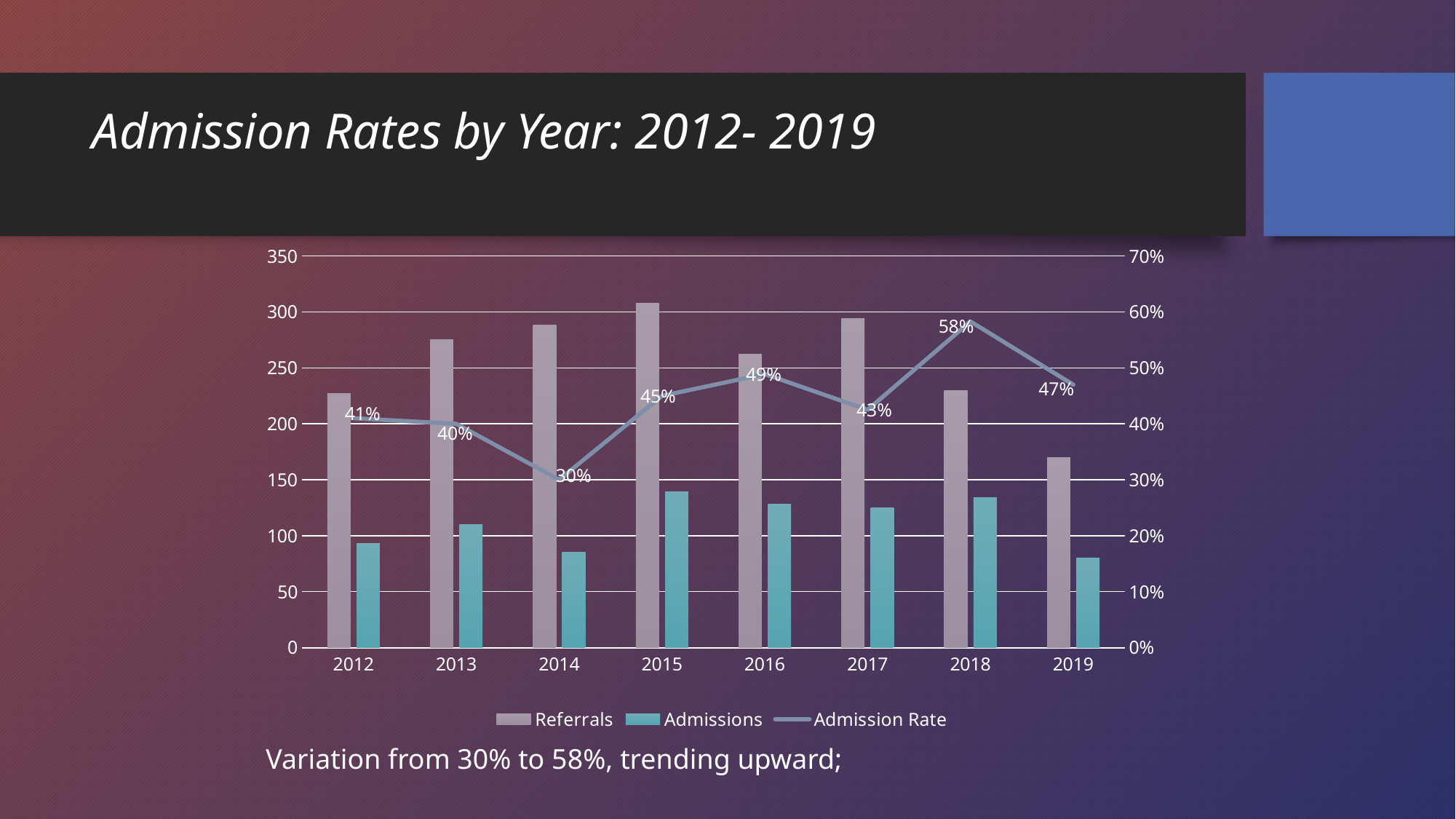
Which year has the highest Admission Rate? 2018 How many series does the legend list? 3 Which year has the lowest Admission Rate? 2014 Which year has the highest Referrals bar? 2015 What is the difference between the Admission Rate in 2018 and in 2014? 28% Which year has a higher Admission Rate, 2015 or 2017? 2015 How many years are shown on the x axis? 8 Is the Referrals value for 2015 greater or less than 300? greater What is the Admission Rate for 2014? 30% What is the Admission Rate for 2018? 58% What is the Admission Rate for 2016? 49% Is the Admissions value for 2019 greater or less than 100? less